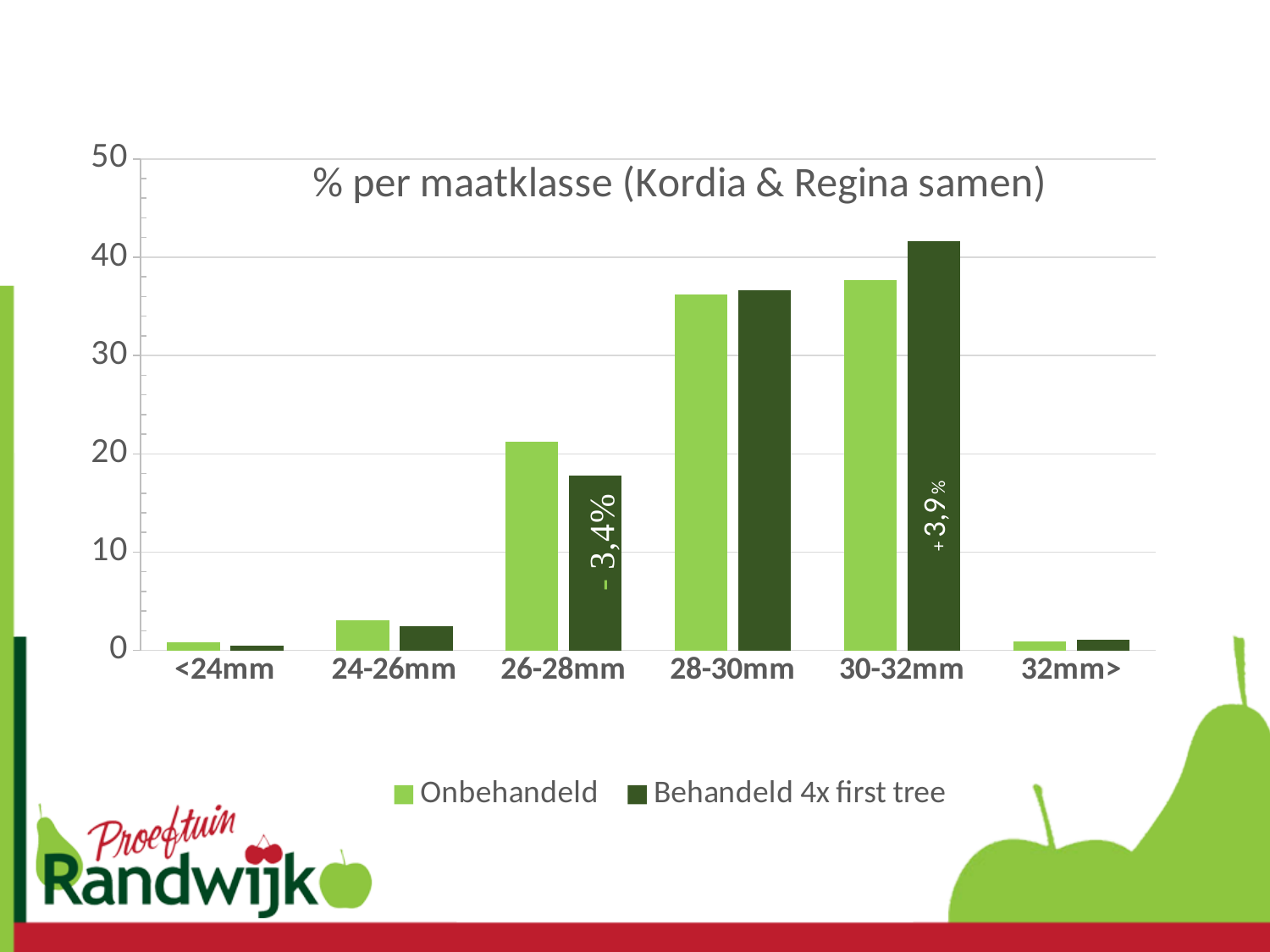
What is the title of the chart? % per maatklasse (Kordia & Regina samen) Is the Behandeld 4x first tree value for 30-32mm greater or less than 40? greater How many series does the legend list? 2 Is the Onbehandeld value for 26-28mm greater or less than 20? greater For the 26-28mm size class, which series has the larger value, Onbehandeld or Behandeld 4x first tree? Onbehandeld For the 30-32mm size class, which series has the larger value, Onbehandeld or Behandeld 4x first tree? Behandeld 4x first tree Which size class has the lowest value for the Behandeld 4x first tree series? <24mm Is the Behandeld 4x first tree value for 26-28mm greater or less than 20? less Which size class has the highest value for the Behandeld 4x first tree series? 30-32mm How many size classes (categories) are shown on the x axis? 6 Which size class has the highest value for the Onbehandeld series? 30-32mm What kind of chart is shown on the slide? bar chart